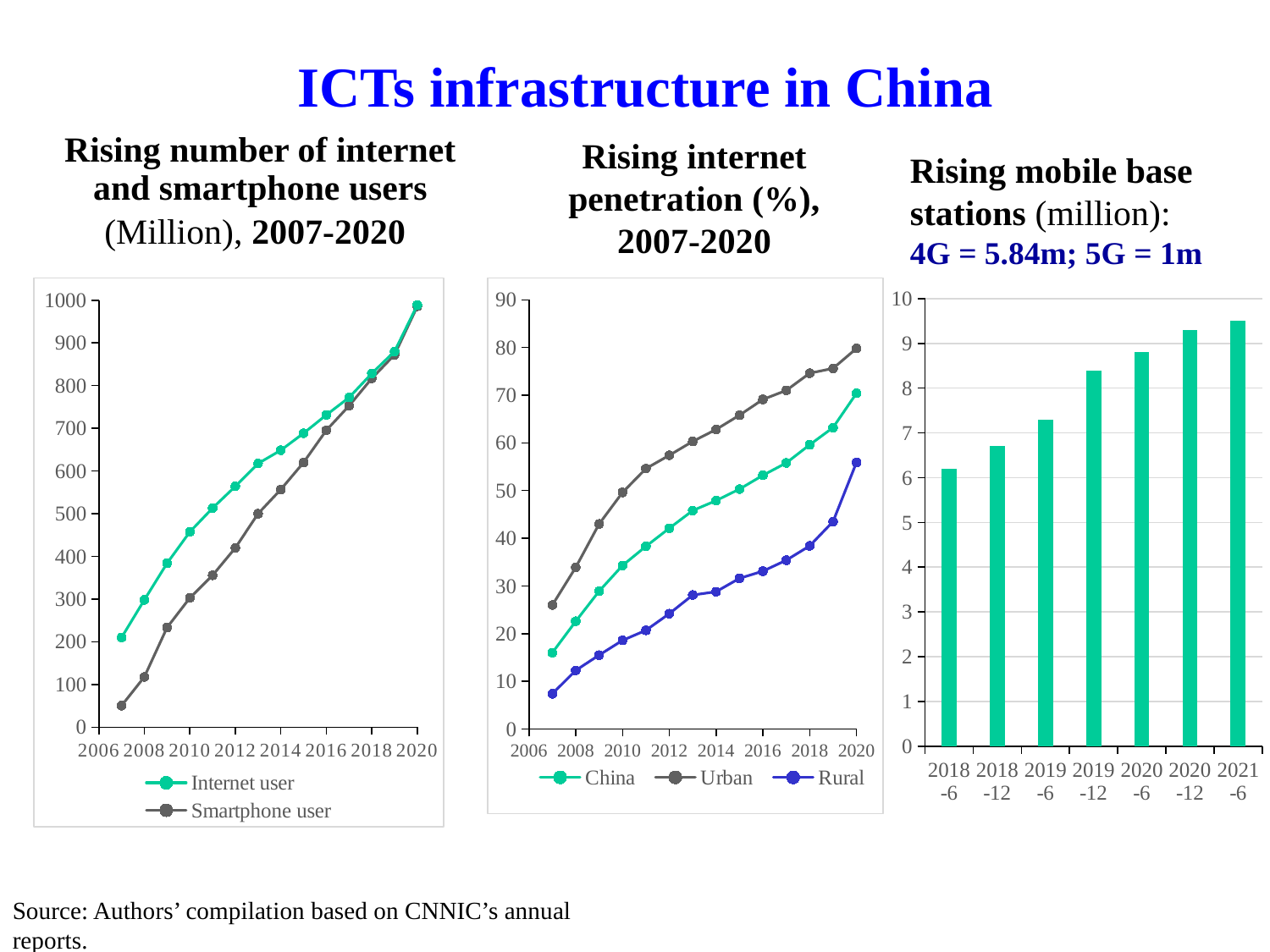
How many bars are shown in the 'Rising mobile base stations' chart? 7 In the 'Rising mobile base stations' chart, which period has the lowest bar? 2018-6 In the 'Rising number of internet and smartphone users' chart, is the Internet user value for 2007 greater or less than 300? less In the 'Rising internet penetration (%)' chart, which series is larger in 2020, Urban or Rural? Urban How many series does the legend of the 'Rising internet penetration (%)' chart list? 3 In the 'Rising mobile base stations' chart, which period has the highest bar? 2021-6 How many series does the legend of the 'Rising number of internet and smartphone users' chart list? 2 What type of chart is the 'Rising mobile base stations' chart on the right of the slide? Bar chart In the 'Rising internet penetration (%)' chart, is the Urban value for 2020 greater or less than 70? greater What type of chart is the 'Rising internet penetration (%)' chart in the middle of the slide? Line chart In the 'Rising number of internet and smartphone users' chart, do the Smartphone user values rise or fall from 2007 to 2020? Rise In the 'Rising mobile base stations' chart, is the value for 2018-6 greater or less than 7? less